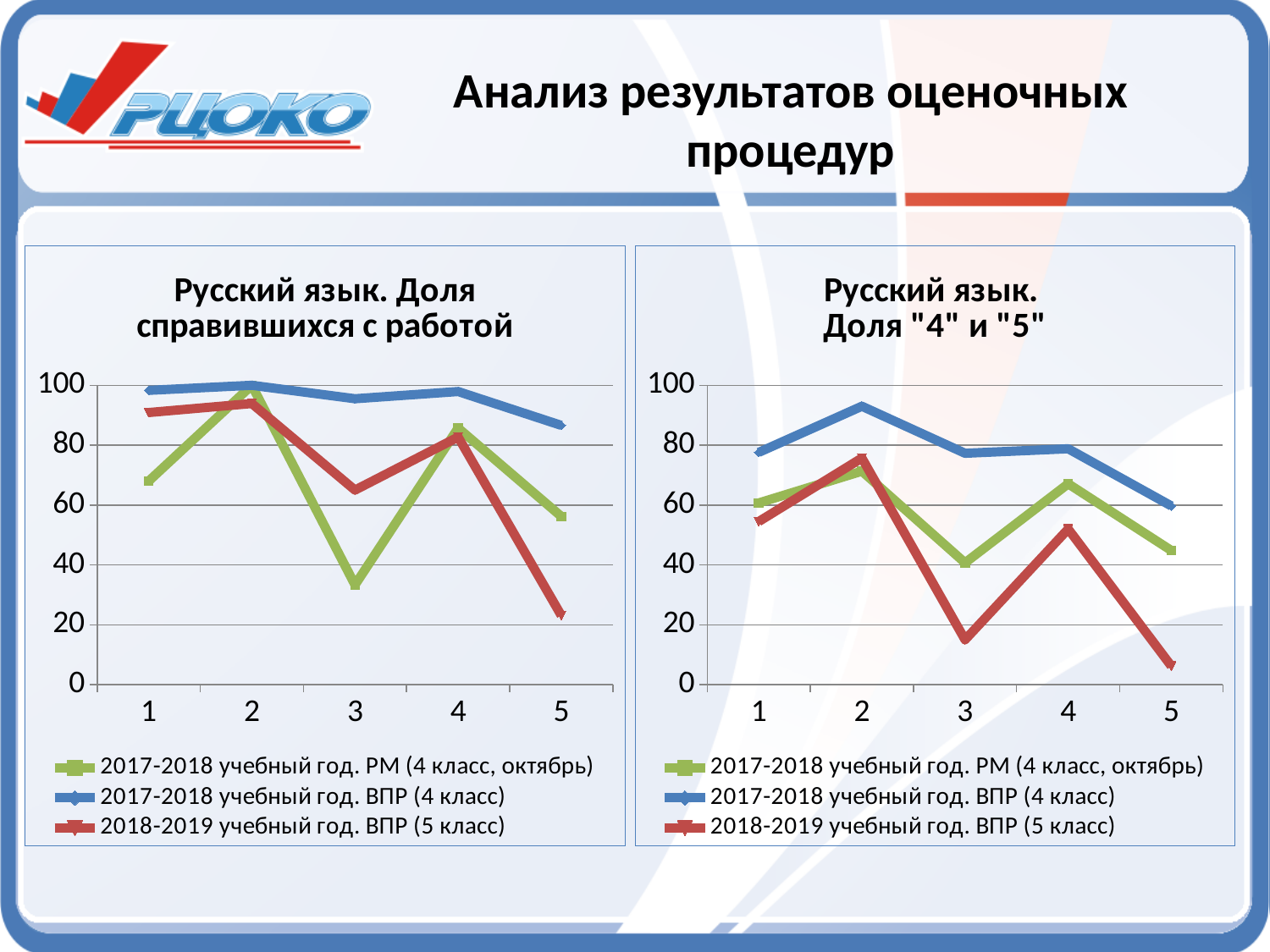
What is the title of the right chart on the slide? Русский язык. Доля "4" и "5" In the right chart, "Русский язык. Доля "4" и "5"", is the value of the series "2017-2018 учебный год. ВПР (4 класс)" at point 2 greater or less than 80? greater In the right chart, "Русский язык. Доля "4" и "5"", at which point does the series "2017-2018 учебный год. ВПР (4 класс)" reach its highest value? 2 In the left chart, "Русский язык. Доля справившихся с работой", at point 3, which series has the larger value: "2017-2018 учебный год. ВПР (4 класс)" or "2017-2018 учебный год. РМ (4 класс, октябрь)"? 2017-2018 учебный год. ВПР (4 класс) In the right chart, "Русский язык. Доля "4" и "5"", is the value of the series "2018-2019 учебный год. ВПР (5 класс)" at point 3 greater or less than 20? less In the left chart, "Русский язык. Доля справившихся с работой", is the value of the series "2017-2018 учебный год. РМ (4 класс, октябрь)" at point 3 greater or less than 40? less In the left chart, "Русский язык. Доля справившихся с работой", at which point does the series "2017-2018 учебный год. РМ (4 класс, октябрь)" reach its lowest value? 3 In the right chart, "Русский язык. Доля "4" и "5"", does the series "2018-2019 учебный год. ВПР (5 класс)" rise or fall from point 4 to point 5? fall How many series does the legend of the right chart, "Русский язык. Доля "4" и "5"", list? 3 What kind of chart is the left chart, "Русский язык. Доля справившихся с работой"? line chart How many points are plotted along the x axis for each series in the left chart, "Русский язык. Доля справившихся с работой"? 5